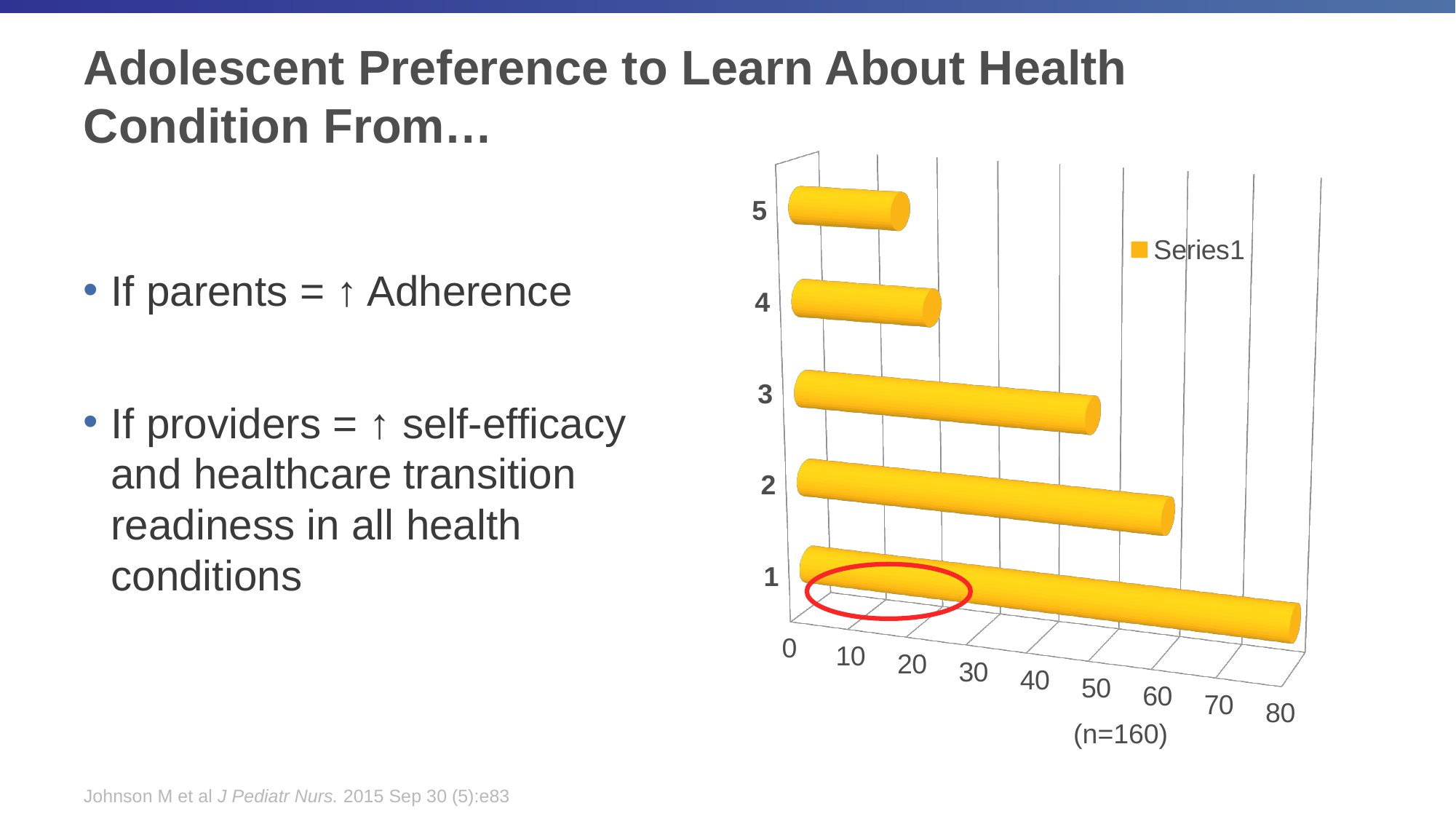
Which category has the shortest bar in the chart? 5 Which has the larger value, category 2 or category 3? category 2 What is the name of the series shown in the chart legend? Series1 How many series does the chart legend list? 1 Which has the larger value, category 4 or category 5? category 4 Which category has the longest bar in the chart? 1 How many categories are plotted in the chart? 5 Is the value for category 1 greater or less than 50? greater Is the value for category 5 greater or less than 30? less Is the value for category 3 greater or less than 30? greater What sample size label is shown beneath the chart's horizontal axis? (n=160) What kind of chart is shown on the slide? bar chart